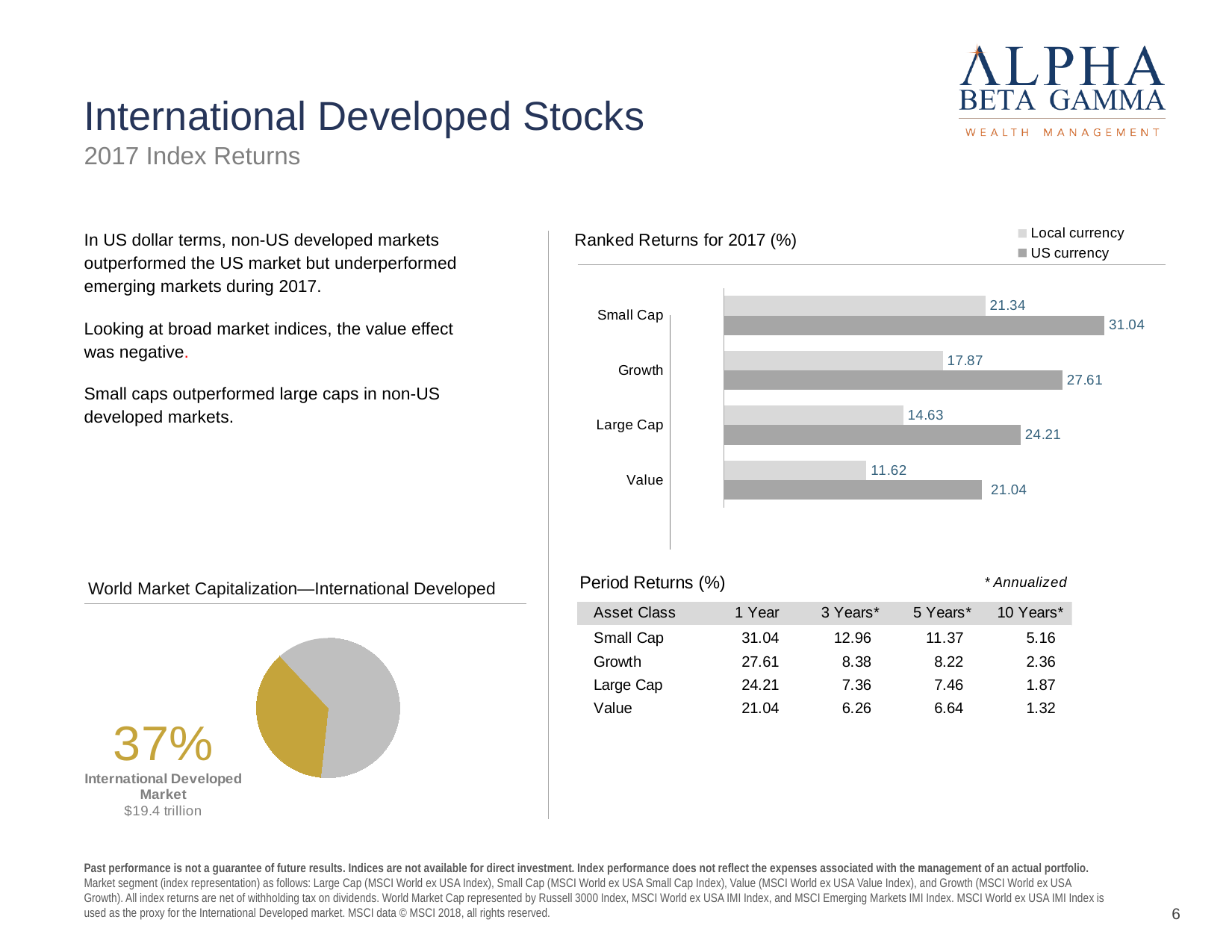
In the Ranked Returns for 2017 chart, what is the Local currency return for Value? 11.62 What kind of chart is the Ranked Returns for 2017 chart? Bar chart In the Ranked Returns for 2017 chart, which category has the highest US currency return? Small Cap How many series does the legend of the Ranked Returns for 2017 chart list? 2 In the Ranked Returns for 2017 chart, what is the US currency return for Small Cap? 31.04 In the Ranked Returns for 2017 chart, which category has the lowest Local currency return? Value How many categories are shown in the Ranked Returns for 2017 chart? 4 In the World Market Capitalization—International Developed pie chart, what share does the International Developed Market slice represent? 37% In the Ranked Returns for 2017 chart, what is the Local currency return for Growth? 17.87 What are the two legend entries in the Ranked Returns for 2017 chart? Local currency and US currency In the Ranked Returns for 2017 chart, which is larger: the US currency return for Growth or the US currency return for Large Cap? Growth In the Ranked Returns for 2017 chart, what is the difference between the US currency and Local currency returns for Large Cap? 9.58